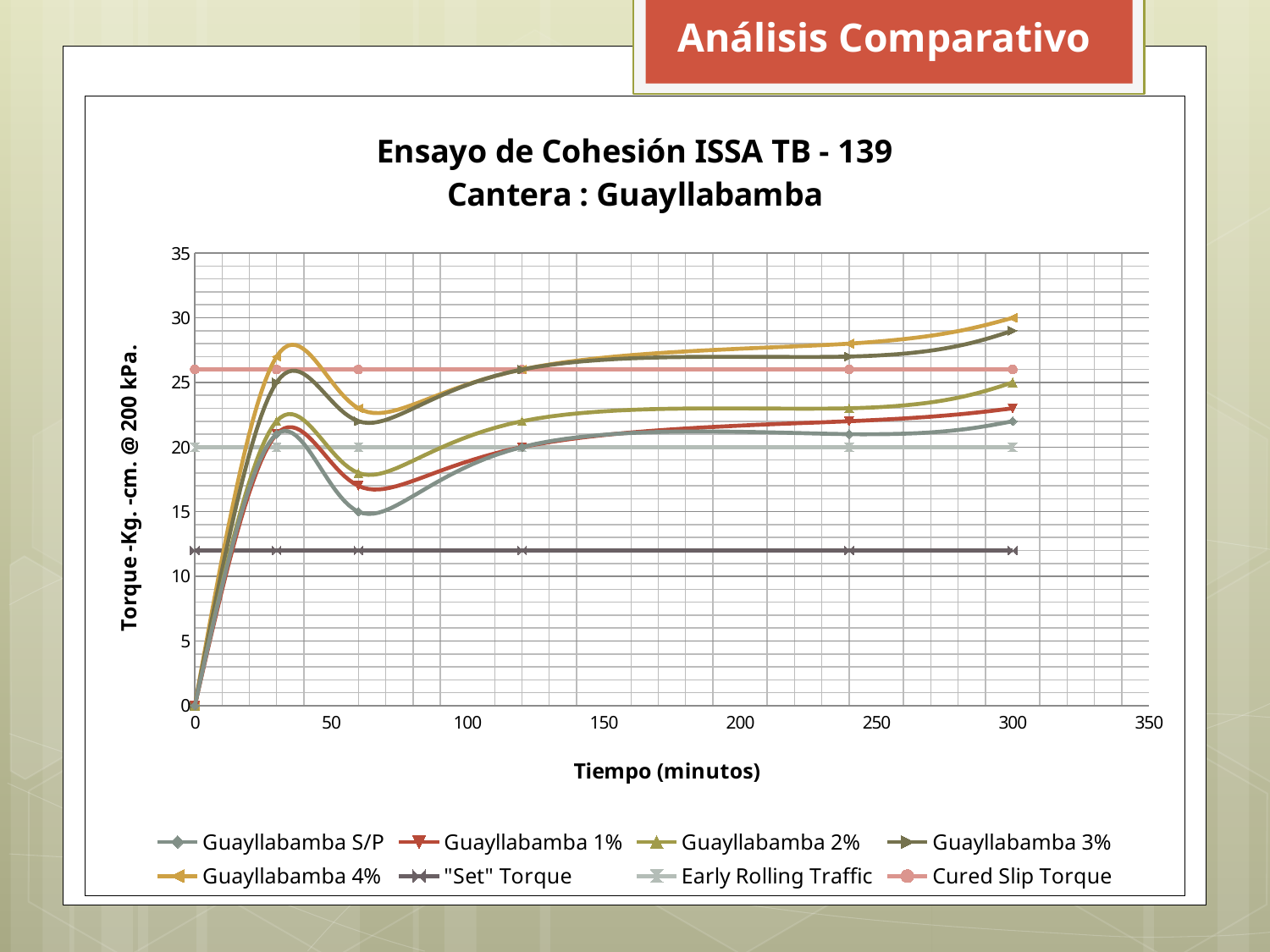
Is the value of the "Set" Torque line greater or less than 15? less What is the label of the x axis? Tiempo (minutos) Does the Guayllabamba 3% line rise or fall between 120 and 300 minutes? rise Is the value of the Cured Slip Torque line greater or less than 25? greater What is the title of the chart? Ensayo de Cohesión ISSA TB - 139 Cantera : Guayllabamba What constant torque value does the Early Rolling Traffic line sit at? 20 Is the value for Guayllabamba S/P at 60 minutes greater or less than 20? less At 300 minutes, which is larger: Guayllabamba 4% or Guayllabamba S/P? Guayllabamba 4% How many series does the legend list? 8 What kind of chart is shown on the slide? line chart Which Guayllabamba series has the highest torque at 300 minutes? Guayllabamba 4%